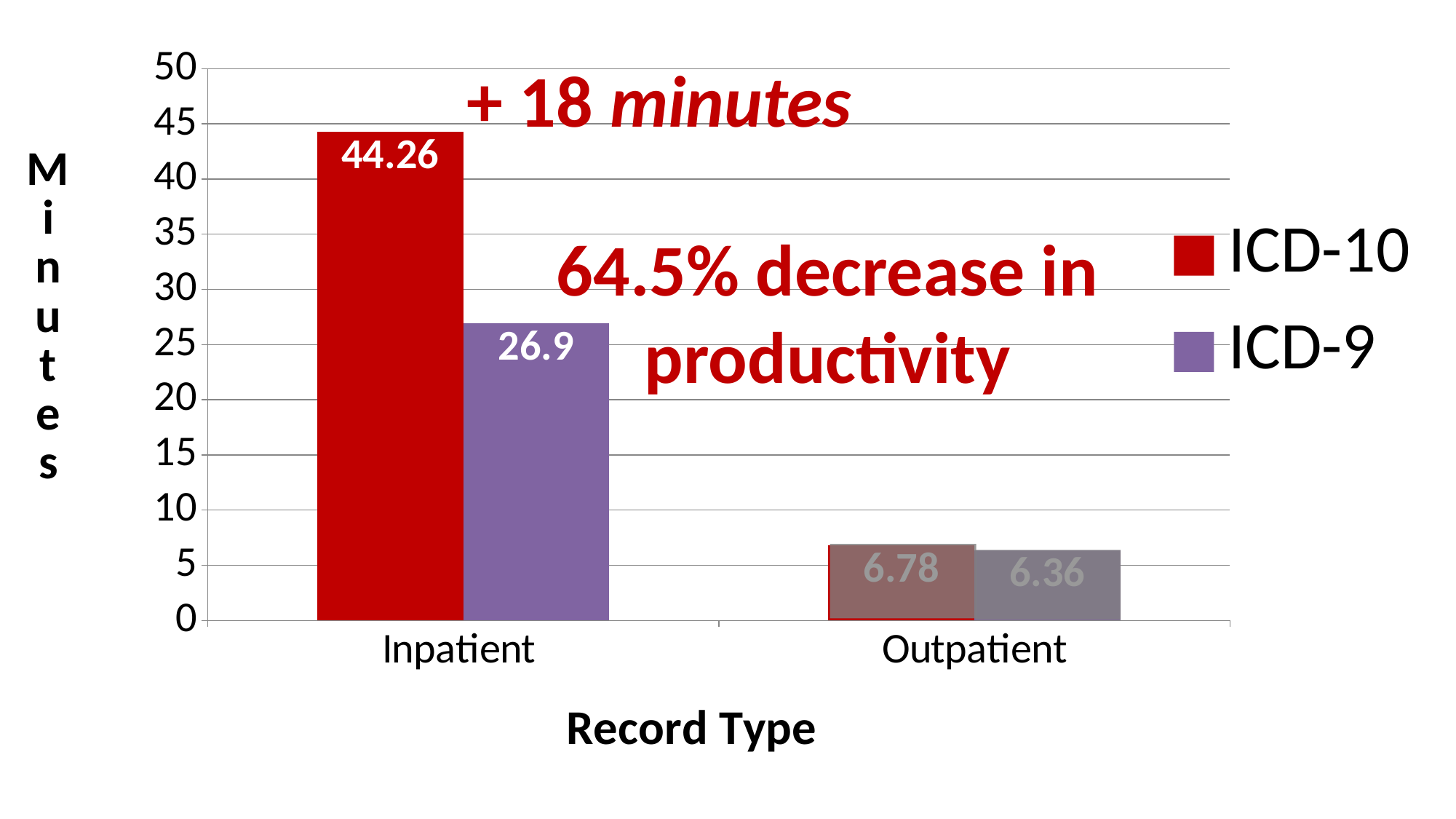
Which record type has the lowest ICD-9 value? Outpatient What kind of chart is shown on the slide? Bar chart Which is larger for Inpatient, the ICD-10 value or the ICD-9 value? ICD-10 What is the difference between the ICD-10 and ICD-9 values for Inpatient? 17.36 Is the ICD-9 value for Inpatient greater or less than 25? greater What is the ICD-10 value for Outpatient? 6.78 What is the ICD-9 value for Inpatient? 26.9 How many series does the legend list? 2 What is the ICD-10 value for Inpatient? 44.26 How many record types are shown on the x axis? 2 Which record type has the highest ICD-10 value? Inpatient What is the ICD-9 value for Outpatient? 6.36